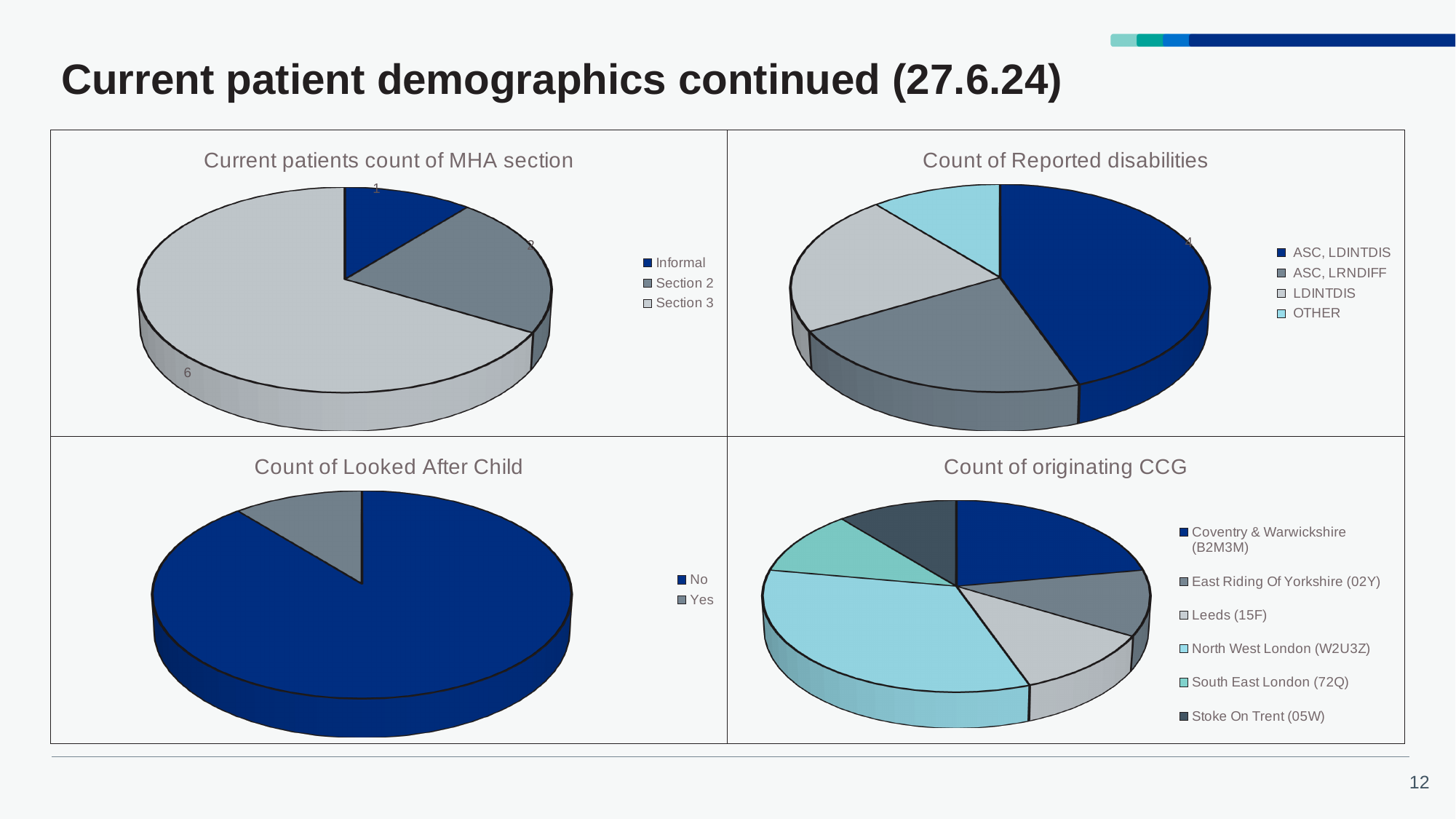
In the "Count of Reported disabilities" chart, which category has the largest slice? ASC, LDINTDIS In the "Count of originating CCG" chart, which category has the largest slice? North West London (W2U3Z) How many categories does the legend of the "Count of Reported disabilities" chart list? 4 In the "Current patients count of MHA section" chart, what is the difference between the values for Section 3 and Informal? 5 What kind of chart is "Current patients count of MHA section"? pie chart In the "Count of Looked After Child" chart, which is larger, No or Yes? No In the "Current patients count of MHA section" chart, what is the value for Section 3? 6 In the "Current patients count of MHA section" chart, what is the value for Informal? 1 In the "Current patients count of MHA section" chart, which category has the largest slice? Section 3 How many categories does the legend of the "Count of originating CCG" chart list? 6 In the "Current patients count of MHA section" chart, which category has the smallest slice? Informal How many categories does the "Current patients count of MHA section" chart show? 3